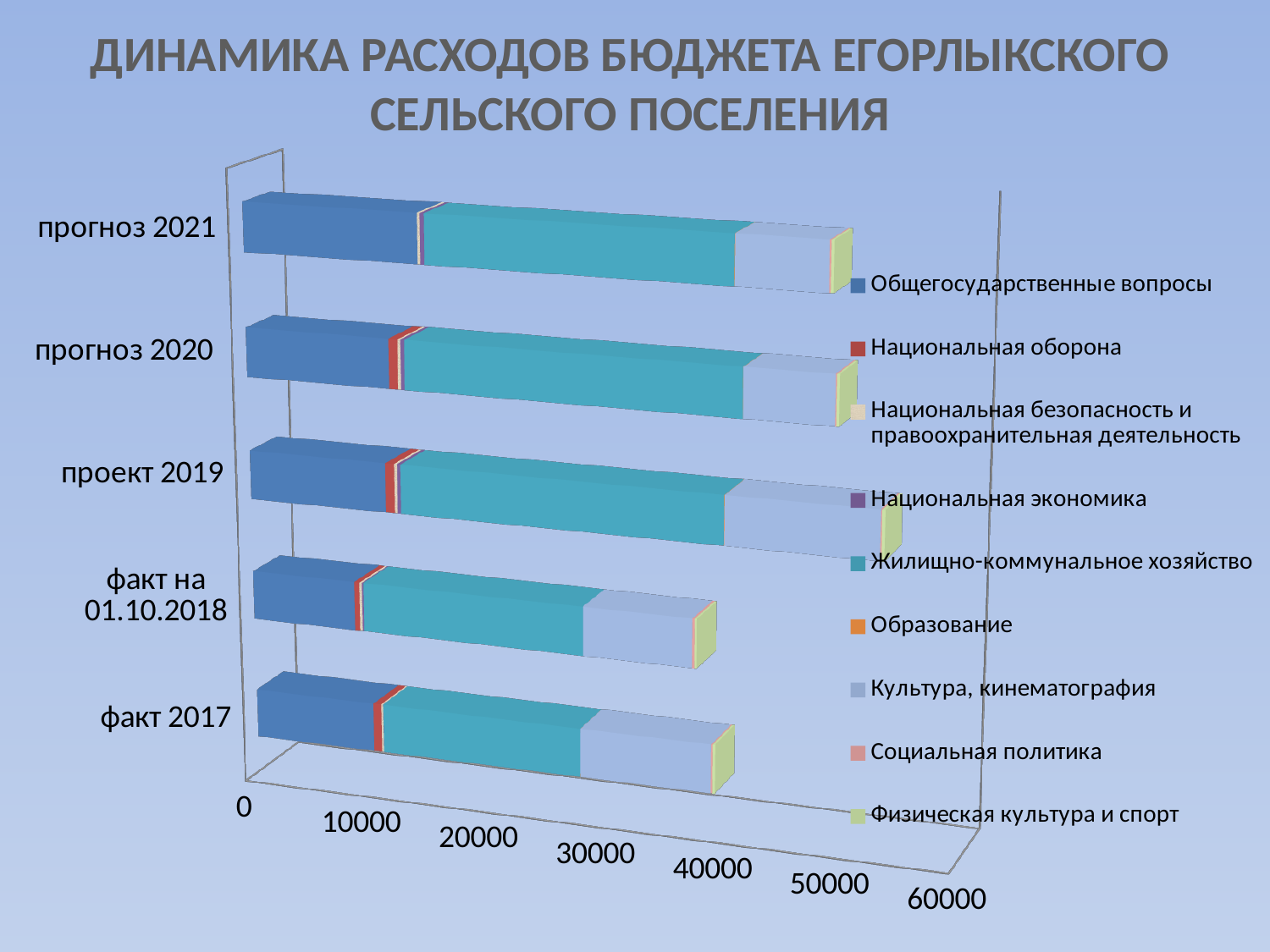
What is the title of the chart on the slide? ДИНАМИКА РАСХОДОВ БЮДЖЕТА ЕГОРЛЫКСКОГО СЕЛЬСКОГО ПОСЕЛЕНИЯ Is the total bar for факт на 01.10.2018 greater or less than 30000? greater What is the highest value shown on the horizontal axis of the chart? 60000 Is the total bar for прогноз 2021 greater or less than 40000? greater Which has the longer total bar: проект 2019 or факт на 01.10.2018? проект 2019 Which series is listed first in the chart legend? Общегосударственные вопросы Which period has the shortest total bar in the chart? факт на 01.10.2018 How many categories (periods) are shown on the vertical axis of the chart? 5 How many series does the chart legend list? 9 Is the total bar for проект 2019 greater or less than 40000? greater What kind of chart is shown on the slide? Stacked bar chart